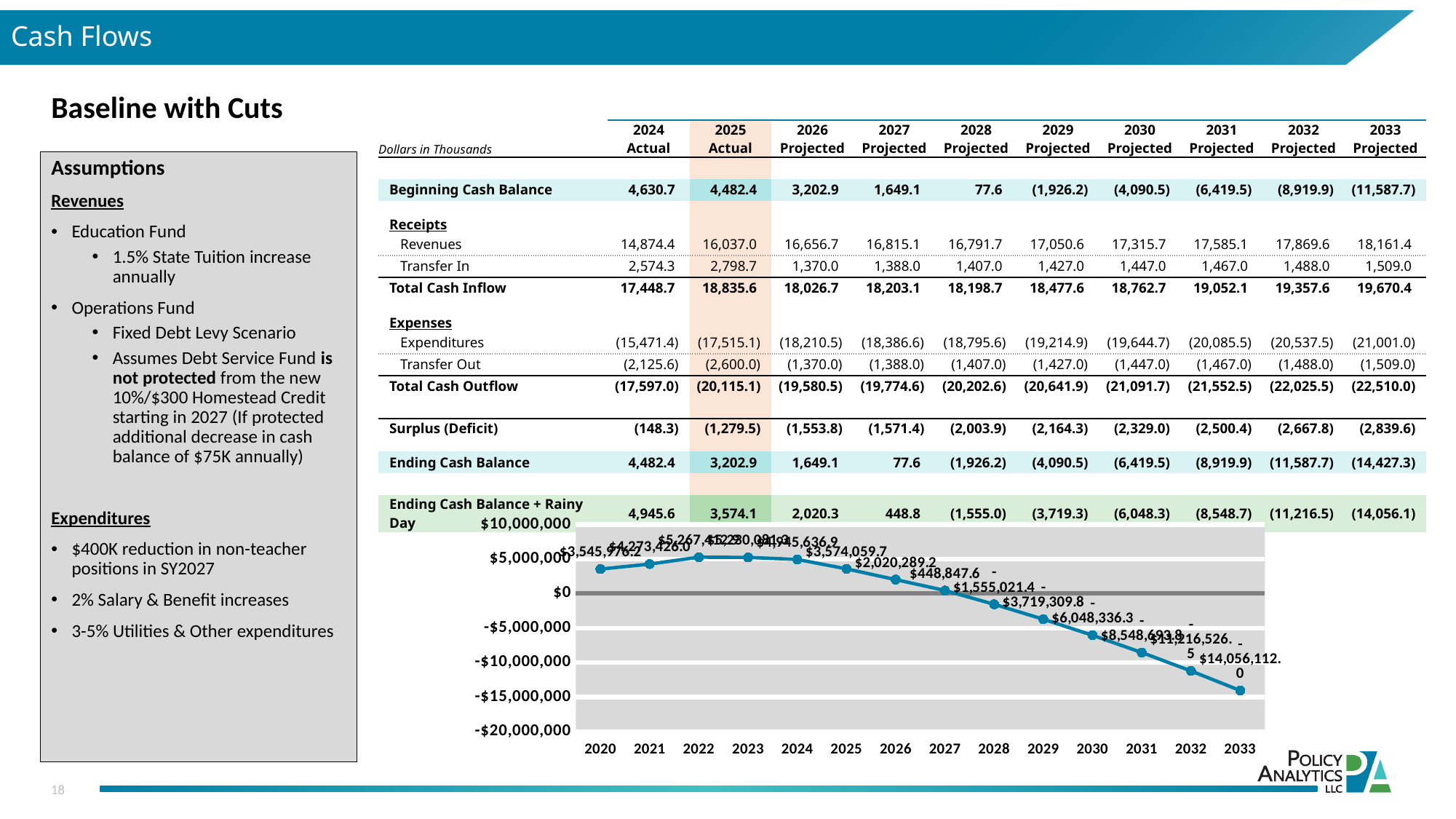
What is the difference between the 2026 and 2027 values in the line chart? $1,571,441.6 Is the value for 2030 in the line chart greater or less than -$5,000,000? less What is the value plotted for 2020 in the line chart? $3,545,976.2 In the line chart, which is larger, the value for 2021 or the value for 2025? 2021 What is the value plotted for 2021 in the line chart? $4,273,426.0 What is the value plotted for 2027 in the line chart? $448,847.6 Which year has the highest value in the line chart? 2022 How many years are plotted on the x axis of the line chart? 14 Which year has the lowest value in the line chart? 2033 What is the value plotted for 2025 in the line chart? $3,574,059.7 What kind of chart is shown at the bottom of the slide? line chart Is the value for 2033 in the line chart greater or less than -$10,000,000? less